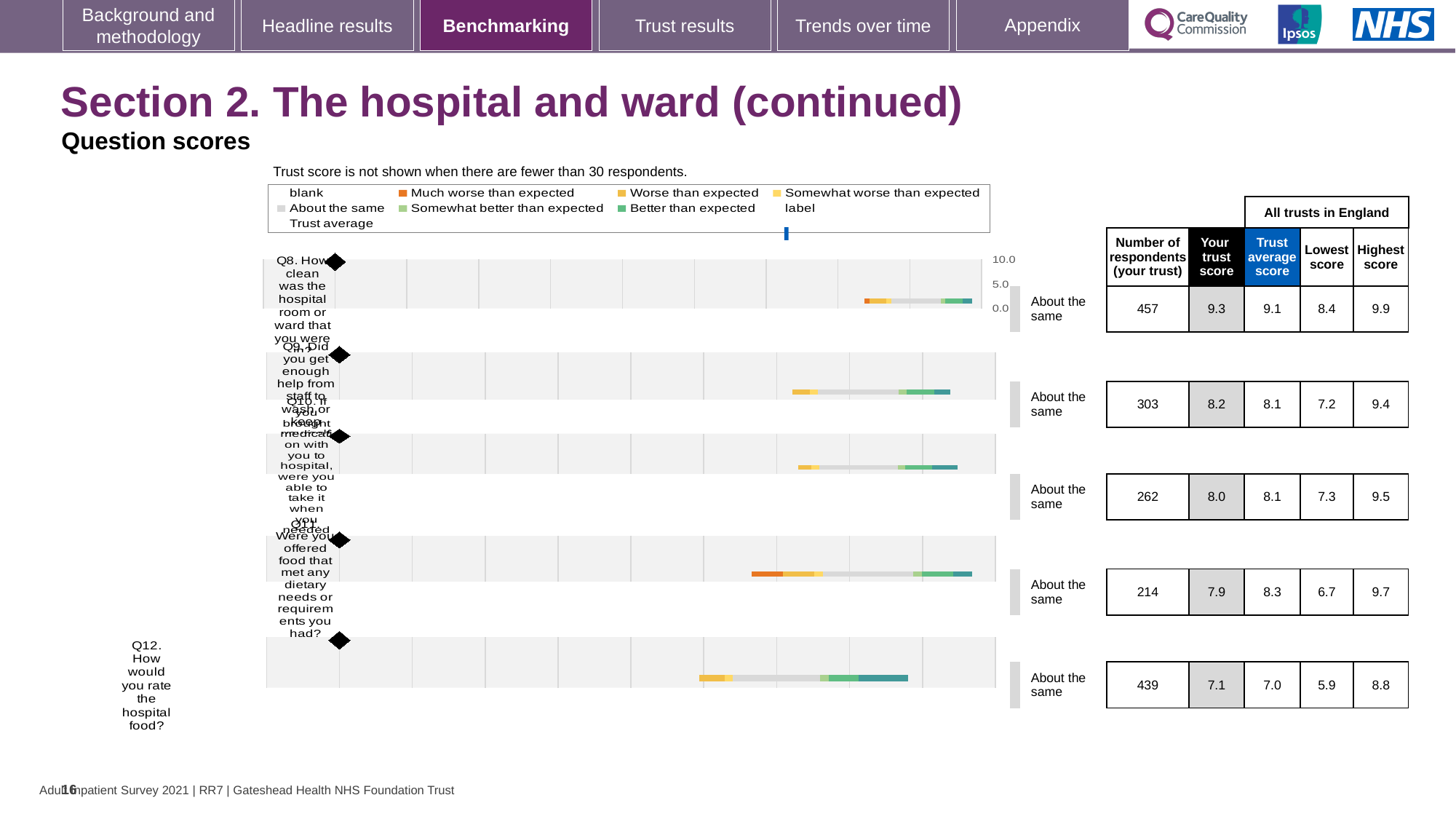
Which question has the lowest 'Your trust score'? Q12 What is the 'Your trust score' for Q8 (How clean was the hospital room or ward)? 9.3 What kind of chart is used to show the question scores on this slide? Bar chart What benchmark category is shown next to every question in the chart? About the same What colour does the legend use for 'Much worse than expected'? Orange Which question has the highest 'Your trust score'? Q8 For Q11, which is larger: 'Your trust score' or the 'Trust average score'? Trust average score For Q8, what is the difference between 'Your trust score' and the 'Trust average score'? 0.2 What is the 'Highest score' across all trusts in England for Q10? 9.5 How many questions (Q8 to Q12) are plotted in the chart? 5 What is the 'Lowest score' across all trusts in England for Q11? 6.7 How many respondents from your trust answered Q12 (How would you rate the hospital food)? 439